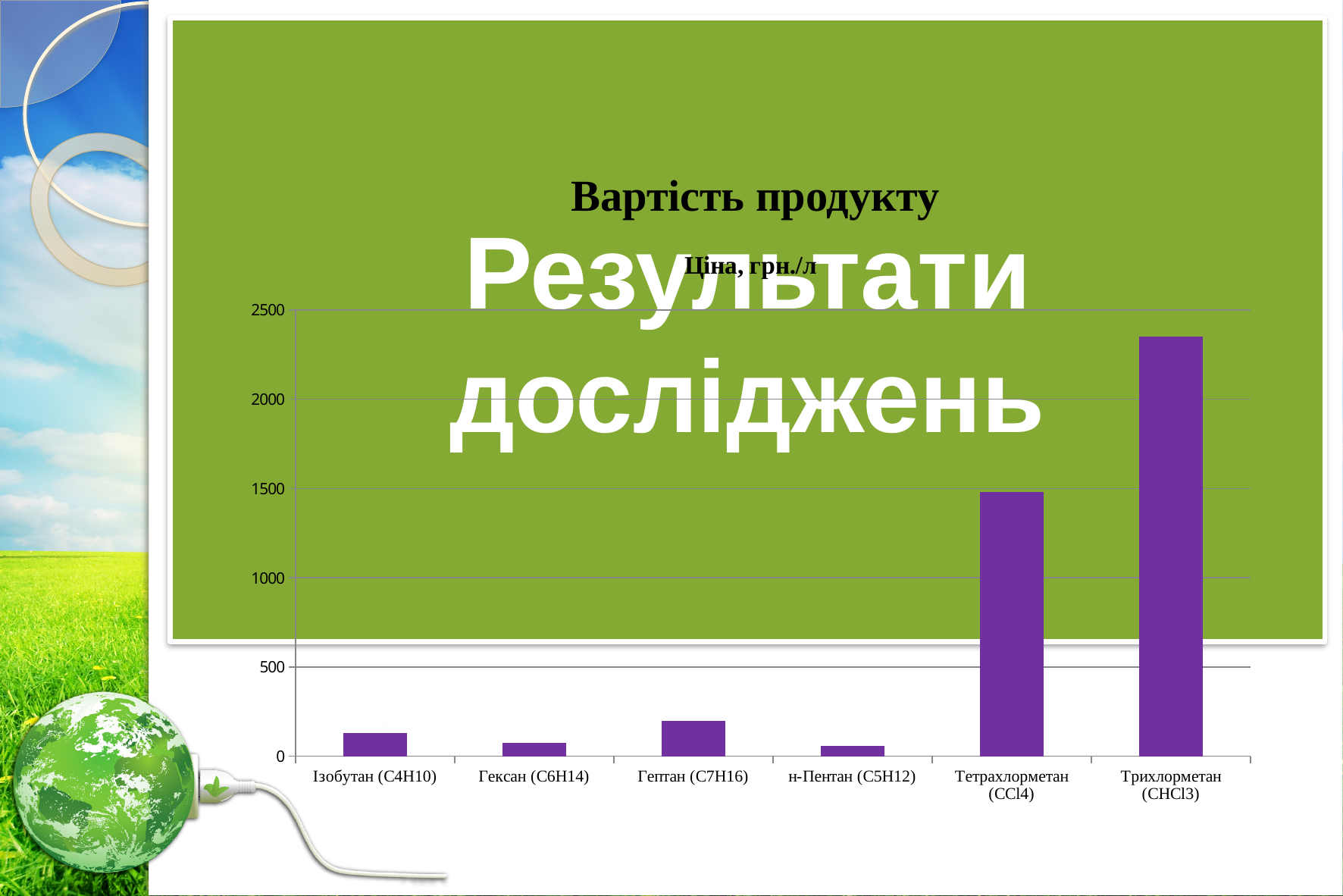
Which category has the highest value? Трихлорметан (CHCl3) Is the value for Гептан (C7H16) greater or less than 500? less What kind of chart is shown on the slide? bar chart What is the title of the chart? Вартість продукту What unit is given in the chart's subtitle? Ціна, грн./л Which is larger, the value for Гексан (C6H14) or Тетрахлорметан (CCl4)? Тетрахлорметан (CCl4) Which is larger, the value for Гептан (C7H16) or Ізобутан (C4H10)? Гептан (C7H16) Which is larger, the value for Тетрахлорметан (CCl4) or Трихлорметан (CHCl3)? Трихлорметан (CHCl3) Is the value for Тетрахлорметан (CCl4) greater or less than 1000? greater Is the value for Трихлорметан (CHCl3) greater or less than 2000? greater How many categories are plotted on the x axis? 6